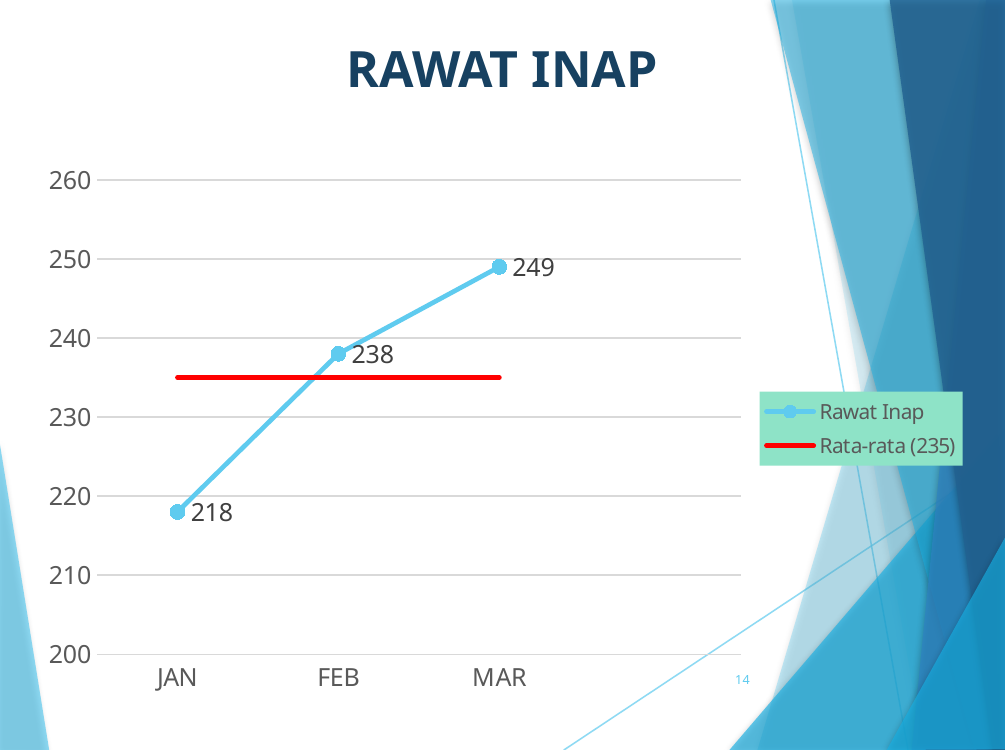
Which month has the lowest Rawat Inap value? JAN What is the Rawat Inap value for JAN? 218 Do the Rawat Inap values rise or fall from JAN to MAR? rise Which is larger, the Rawat Inap value for FEB or for JAN? FEB What is the difference between the Rawat Inap values for MAR and JAN? 31 Which month has the highest Rawat Inap value? MAR How many months are plotted on the x axis? 3 What is the Rawat Inap value for MAR? 249 How many series does the legend list? 2 What is the Rawat Inap value for FEB? 238 Is the Rawat Inap value for JAN greater or less than 220? less What kind of chart is shown on the slide? line chart